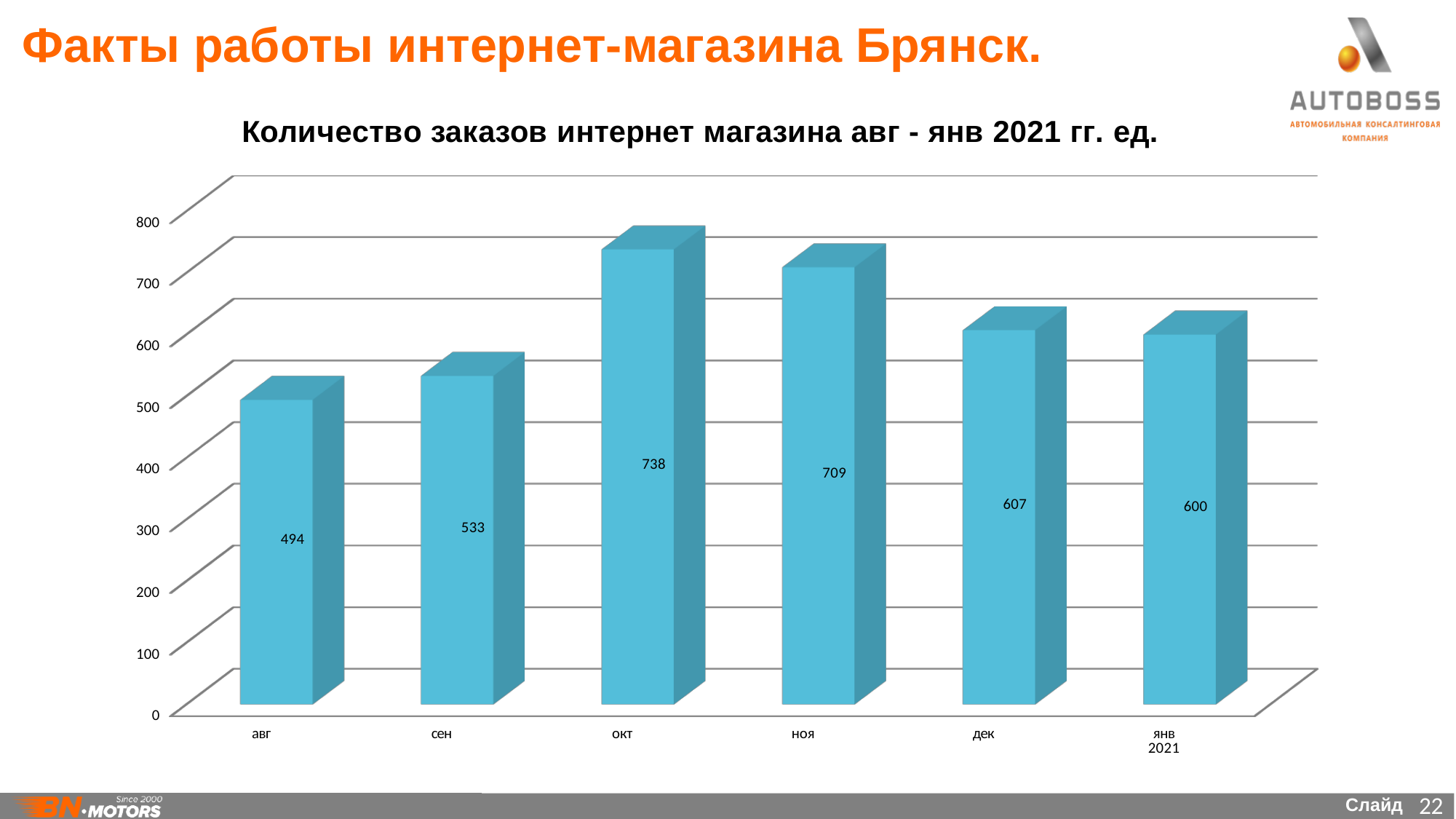
What kind of chart is shown on the slide? bar chart What is the difference between the values for сен and авг? 39 Which month has the lowest number of orders? авг Which month has the highest number of orders? окт What is the title of the chart? Количество заказов интернет магазина авг - янв 2021 гг. ед. What is the difference between the values for окт and ноя? 29 Is the value for ноя greater or less than 700? greater How many months are shown on the chart? 6 What is the value shown for янв 2021? 600 Which is larger, the value for дек or the value for янв 2021? дек What is the number of orders for авг? 494 What is the number of orders for окт? 738